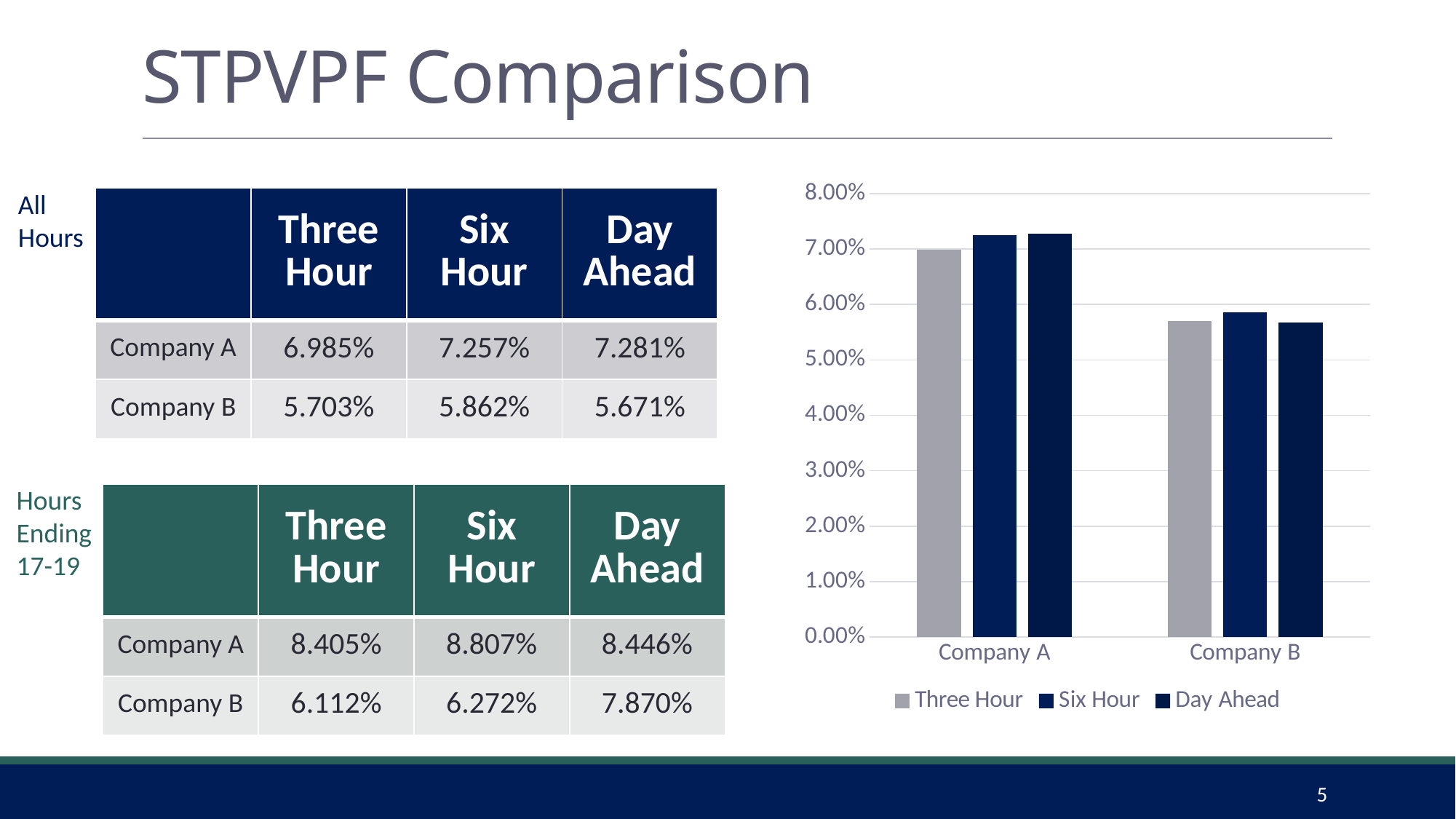
Which series is shown in grey in the chart? Three Hour What is the highest value shown on the chart's y axis? 8.00% How many categories are shown on the x axis of the chart? 2 For Company B, which series has the highest bar in the chart? Six Hour For Company A, which series has the lowest bar in the chart? Three Hour Is the Day Ahead value for Company B greater or less than 6.00%? less Which company has the higher Six Hour value in the chart? Company A Is the Six Hour value for Company B greater or less than 5.00%? greater Is the Day Ahead value for Company A greater or less than 7.00%? greater How many series does the chart legend list? 3 What kind of chart is shown on the slide? bar chart